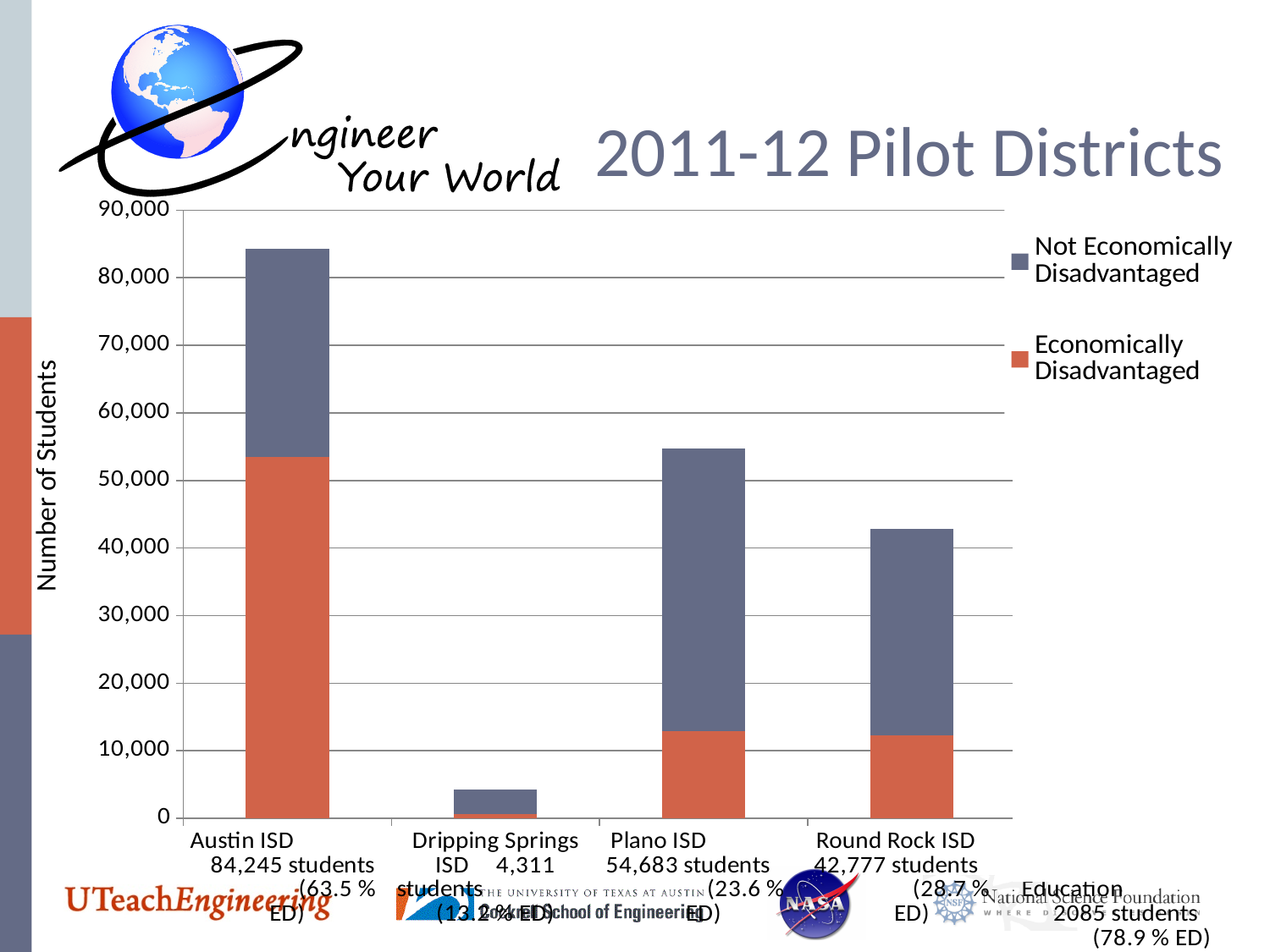
What is the difference in total students between Austin ISD and Plano ISD? 29,562 Is the total number of students for Round Rock ISD greater or less than 50,000? less How many series does the legend list? 2 What kind of chart is shown on the slide? Stacked bar chart Which colour represents the Economically Disadvantaged series? Orange Which district has the lowest total number of students among the plotted bars? Dripping Springs ISD Is the Economically Disadvantaged portion of the Austin ISD bar greater or less than 50,000? greater What percentage of Plano ISD students are economically disadvantaged, according to the axis label? 23.6 % How many students does the label for Austin ISD report? 84,245 students Which district has the highest total number of students? Austin ISD What is the title of the chart? 2011-12 Pilot Districts Which has more total students, Plano ISD or Round Rock ISD? Plano ISD